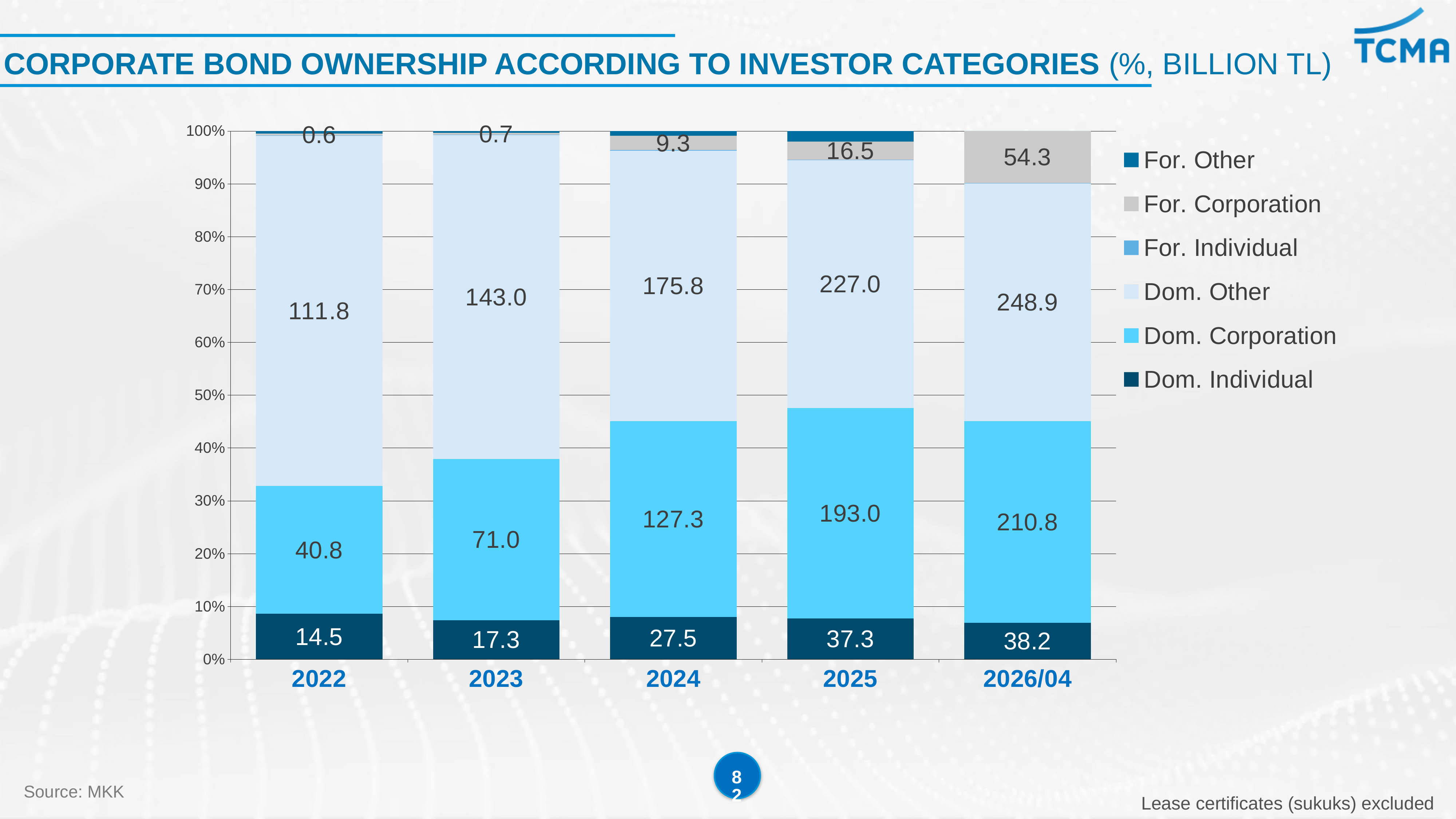
What type of chart is shown on the slide? Stacked bar chart Which is larger in 2023: Dom. Corporation or Dom. Other? Dom. Other How many series does the legend list? 6 What is the value for Dom. Individual in 2024? 27.5 In which year is the Dom. Corporation value highest? 2026/04 What is the difference between the Dom. Other values in 2025 and 2024? 51.2 How many year categories are shown on the x axis? 5 Does the Dom. Individual value rise or fall from 2022 to 2026/04? Rise What is the value for Dom. Other in 2026/04? 248.9 What is the value for Dom. Corporation in 2025? 193.0 In which year is the Dom. Individual value lowest? 2022 What is the value for For. Corporation in 2025? 16.5